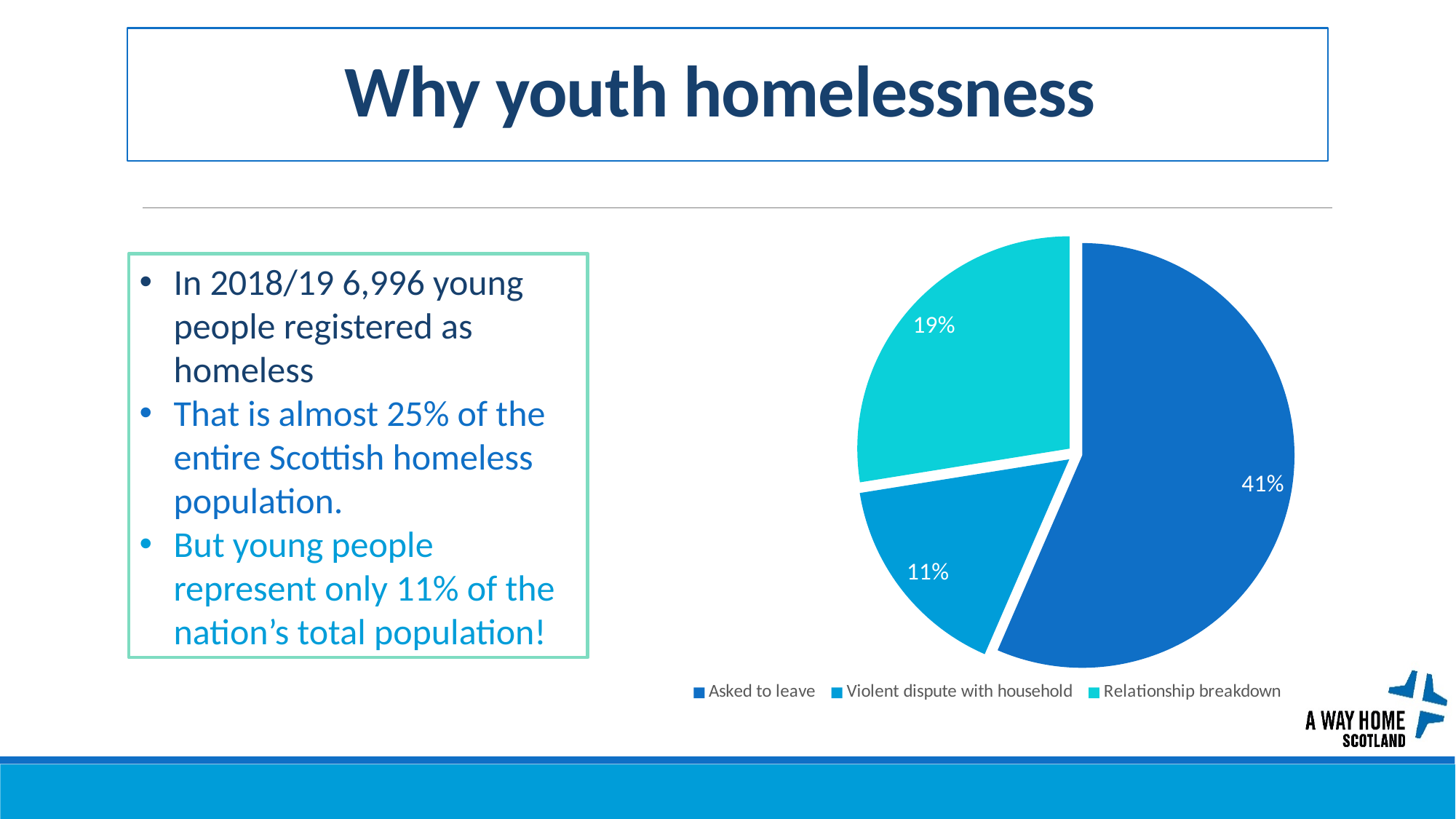
Which legend entry is listed first below the pie chart? Asked to leave Which category has the smallest slice in the pie chart? Violent dispute with household Which category has the largest slice in the pie chart? Asked to leave What percentage of the pie chart is labelled for 'Asked to leave'? 41% What percentage of the pie chart is labelled for 'Violent dispute with household'? 11% Which is larger in the pie chart: 'Relationship breakdown' or 'Violent dispute with household'? Relationship breakdown What colour is the 'Relationship breakdown' slice in the pie chart? light teal/cyan What is the difference in percentage points between 'Asked to leave' and 'Relationship breakdown'? 22 What kind of chart is shown on the slide? pie chart What percentage of the pie chart is labelled for 'Relationship breakdown'? 19% What is the difference in percentage points between 'Relationship breakdown' and 'Violent dispute with household'? 8 How many categories does the legend of the pie chart list? 3